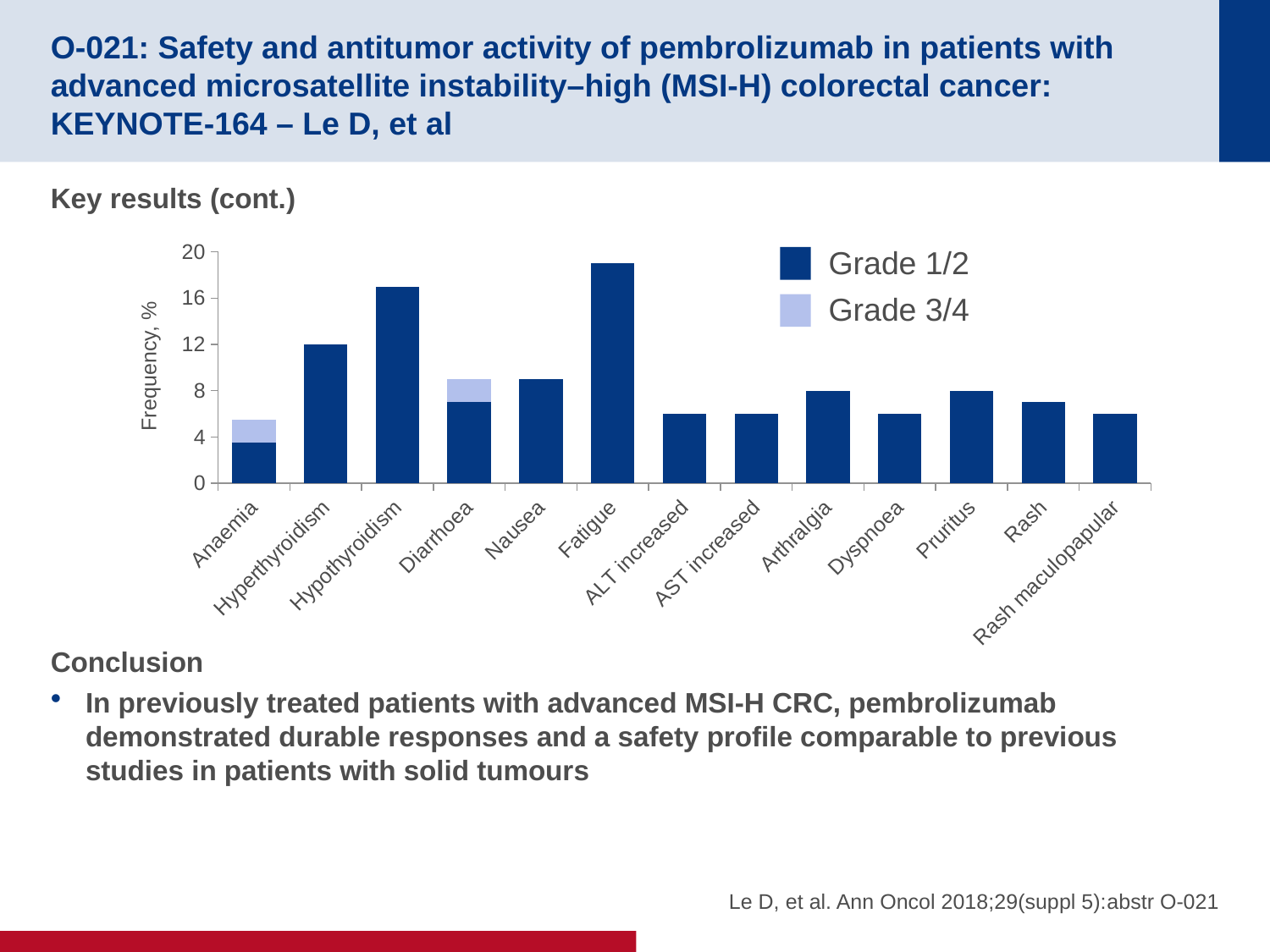
What is the Grade 1/2 frequency for Hyperthyroidism? 12 Is the Grade 1/2 value for Anaemia greater or less than 4? less What kind of chart is shown on the slide? bar chart How many adverse event categories are shown on the x axis? 13 What is the label on the y axis? Frequency, % Which adverse event has the lowest Grade 1/2 frequency? Anaemia How many series does the legend list? 2 What is the Grade 1/2 frequency for Arthralgia? 8 Is the value for Fatigue greater or less than 16? greater What is the Grade 1/2 frequency for Pruritus? 8 Which adverse event has the highest frequency? Fatigue Which is larger, the frequency for Fatigue or for Hypothyroidism? Fatigue